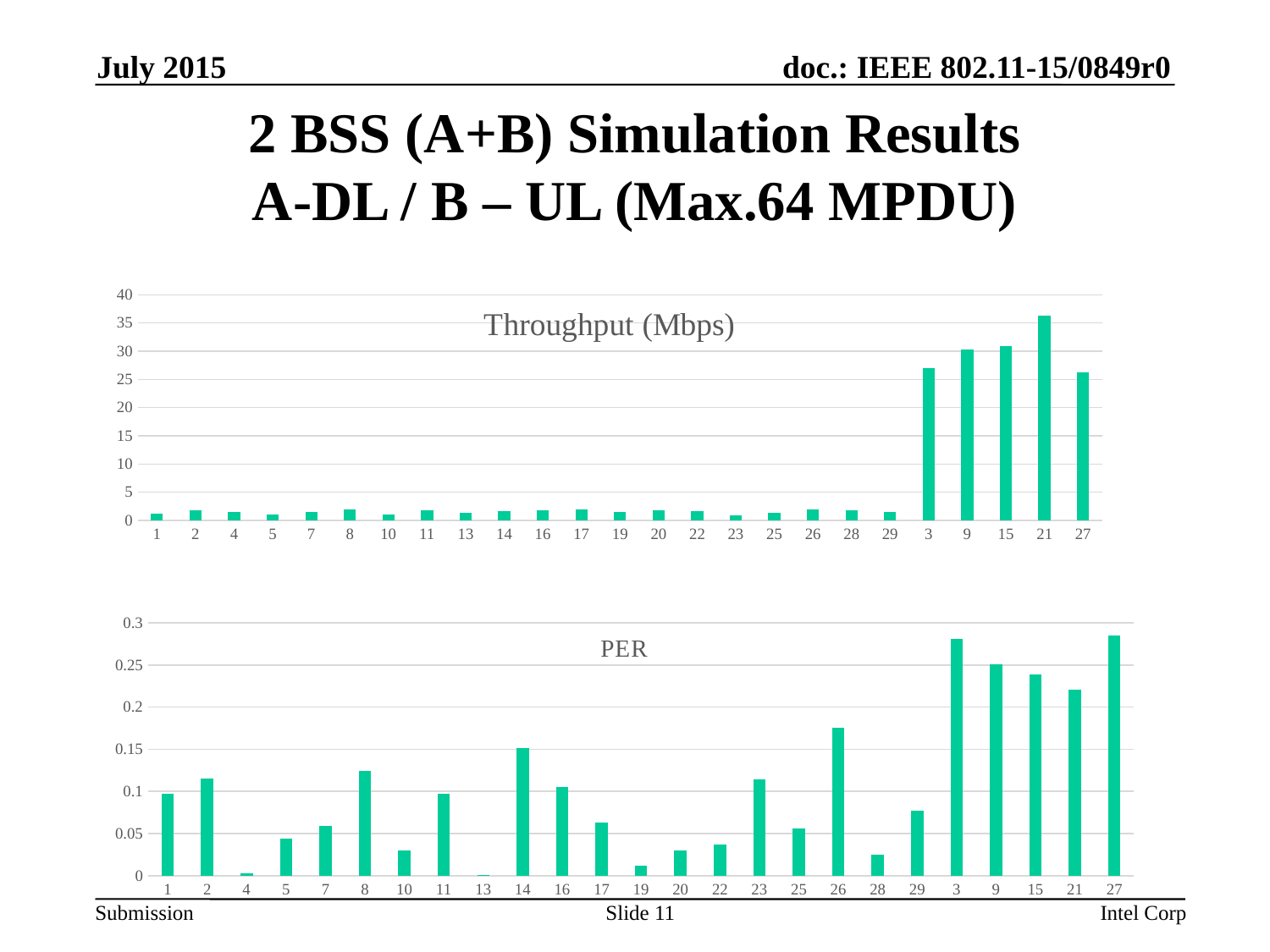
In the Throughput (Mbps) chart, which is larger, the value for category 27 or the value for category 29? 27 How many categories are shown on the x axis of the PER chart? 25 In the Throughput (Mbps) chart, is the value for category 1 greater or less than 5? less In the Throughput (Mbps) chart, which category has the highest throughput? 21 What is the title of the top chart on the slide? Throughput (Mbps) What kind of chart is the Throughput (Mbps) chart? bar chart In the Throughput (Mbps) chart, is the value for category 21 greater or less than 30? greater In the PER chart, is the value for category 21 greater or less than 0.25? less In the PER chart, which is larger, the value for category 14 or the value for category 16? 14